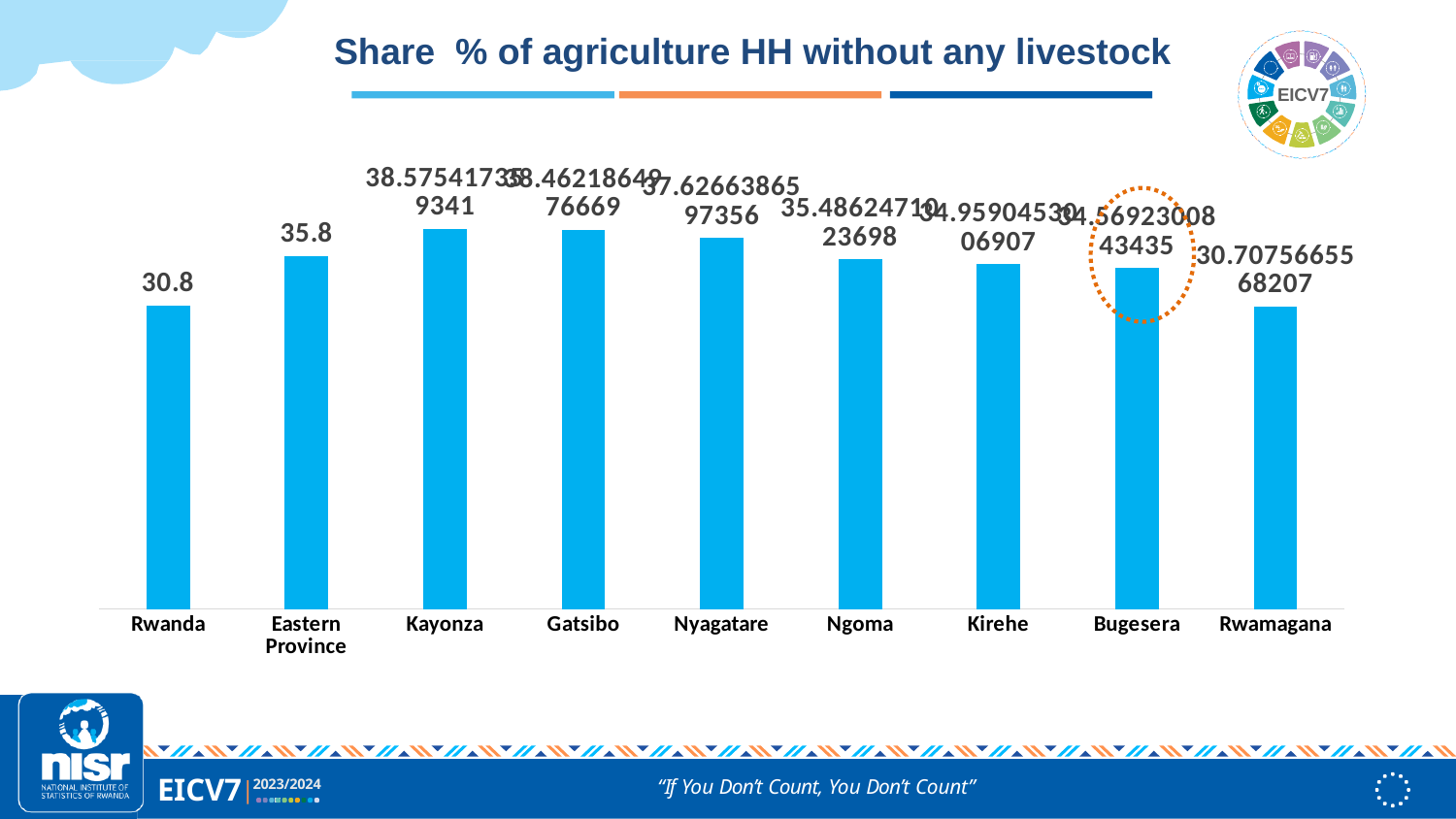
Which is larger, the value for Gatsibo or the value for Bugesera? Gatsibo What is the difference between the values for Eastern Province and Rwanda? 5 What is the value for Eastern Province? 35.8 Do the values rise or fall from Kayonza to Rwamagana along the x axis? Fall What kind of chart is shown on the slide? Bar chart Which is larger, the value for Eastern Province or the value for Kirehe? Eastern Province What is the title of the chart? Share % of agriculture HH without any livestock Which is larger, the value for Nyagatare or the value for Rwamagana? Nyagatare How many categories are shown on the x axis? 9 Which category's bar is highlighted with a dashed orange circle? Bugesera What is the value for Rwanda? 30.8